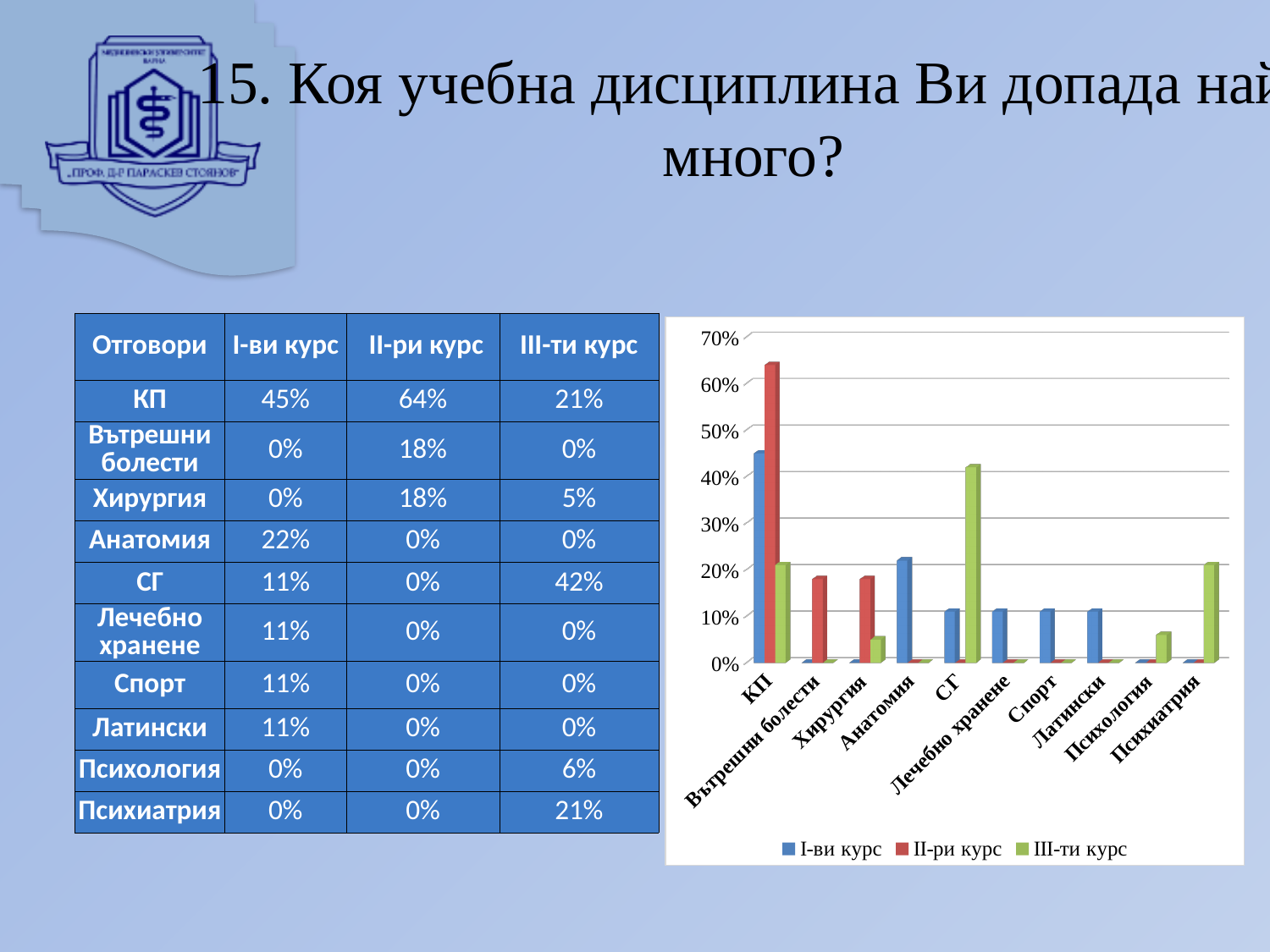
What is the value for КП in the II-ри курс series? 64% Which category has the highest value in the III-ти курс series? СГ What is the value for Анатомия in the I-ви курс series? 22% What is the difference between the II-ри курс and I-ви курс values for КП? 19% Which is larger for Хирургия: the II-ри курс value or the III-ти курс value? II-ри курс What kind of chart is shown on the slide? bar chart What is the value for СГ in the III-ти курс series? 42% How many series does the chart legend list? 3 Which colour represents the III-ти курс series in the chart? green Which category has the highest value in the II-ри курс series? КП Is the value for КП in the II-ри курс series greater or less than 60%? greater How many categories are shown on the x axis of the chart? 10